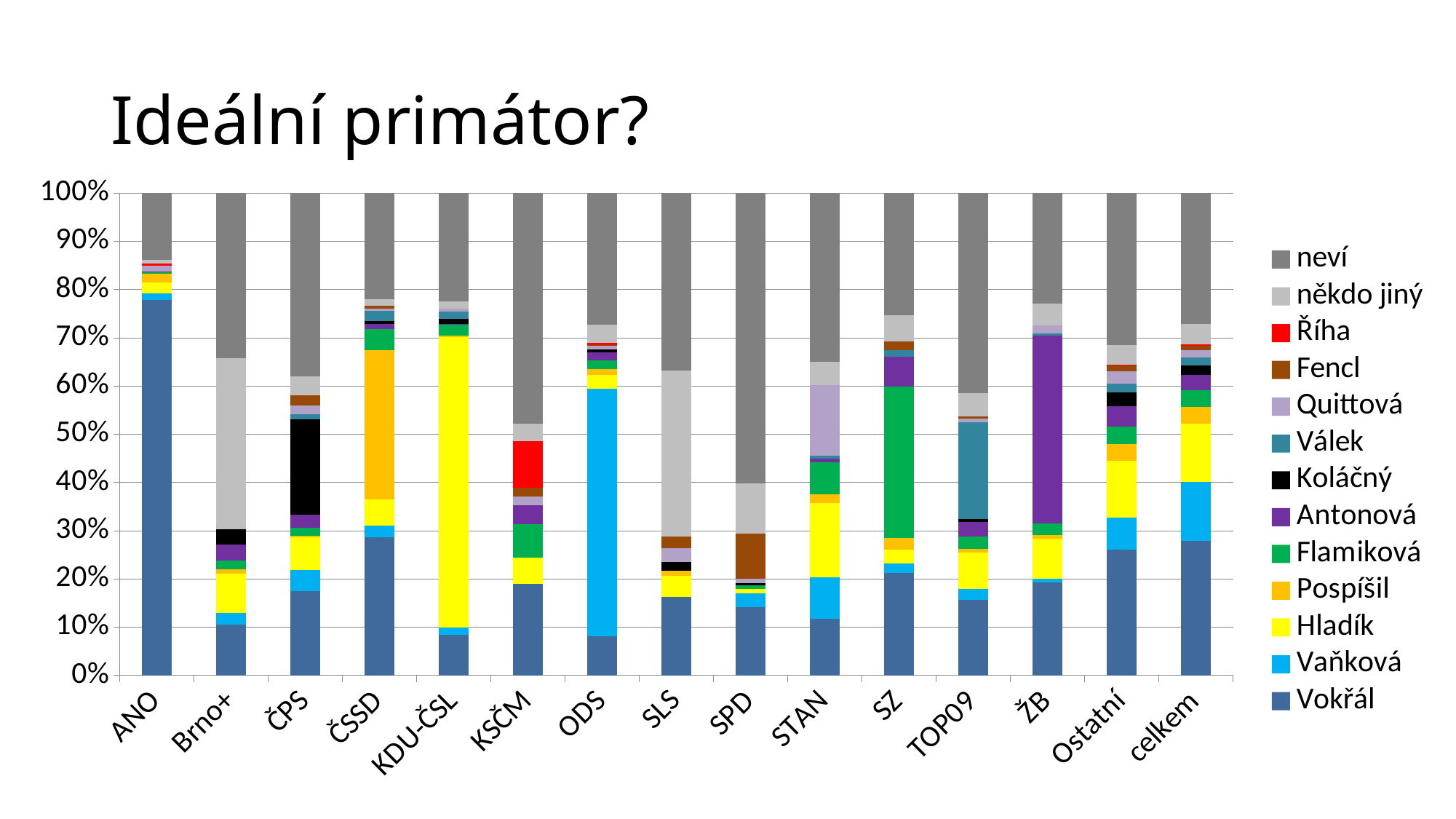
What type of chart is shown on the slide? stacked bar chart Which category has the largest neví segment? SPD Which is larger, the Vokřál share for ANO or for Brno+? ANO Is the Vokřál share for ANO greater or less than 70%? greater What does each stacked bar total? 100% Is the Vokřál share for ODS greater or less than 10%? less Which category has the largest Vokřál segment? ANO Which category has the smallest neví segment? ANO How many categories are shown on the x axis of the chart? 15 Is the Hladík share for KDU-ČSL greater or less than 50%? greater What is the title of the chart? Ideální primátor? How many series does the legend list? 13